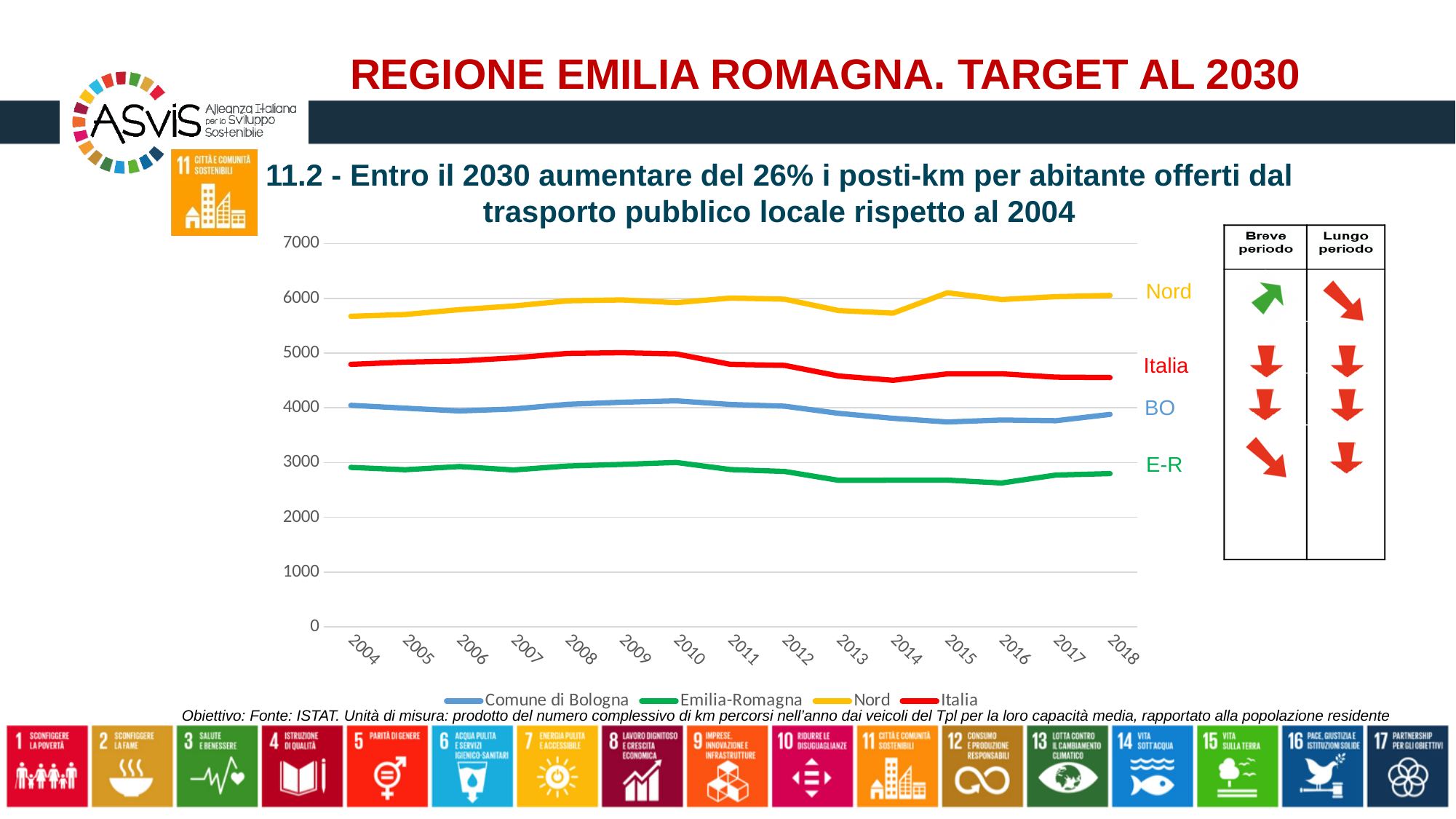
Which series has the highest values across the whole chart? Nord Is the value for Italia in 2018 greater or less than 5000? less In 2018, which is larger: the value for Nord or the value for Italia? Nord What kind of chart is shown on the slide? line chart Which colour is used for the Emilia-Romagna line in the chart? green Is the value for Nord in 2004 greater or less than 5000? greater Does the Italia series rise or fall between 2010 and 2018? fall Which series has the lowest values across the whole chart? Emilia-Romagna Is the value for Comune di Bologna in 2015 greater or less than 4000? less How many series does the legend of the chart list? 4 How many years are shown on the x axis of the chart? 15